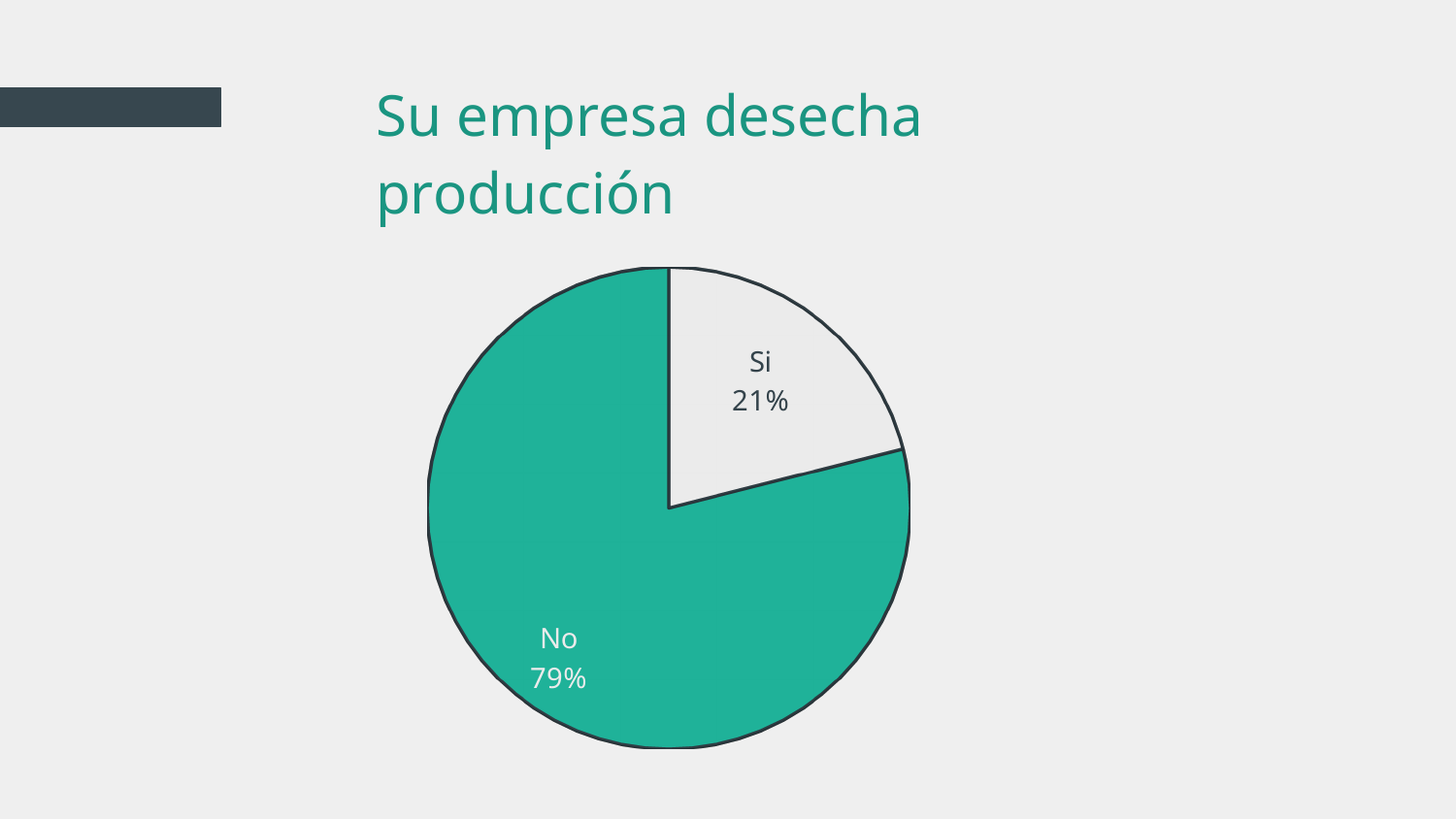
Which slice is the largest in the pie chart? No Which is larger, the "Si" slice or the "No" slice? No What colour is the "No" slice of the pie chart? green What is the difference in percentage points between the "No" and "Si" slices? 58 How many slices does the pie chart have? 2 What share of the pie does the "No" slice represent? 79% Which slice is the smallest in the pie chart? Si What kind of chart is shown on the slide? pie chart What is the title of the chart on the slide? Su empresa desecha producción What share of the pie does the "Si" slice represent? 21%